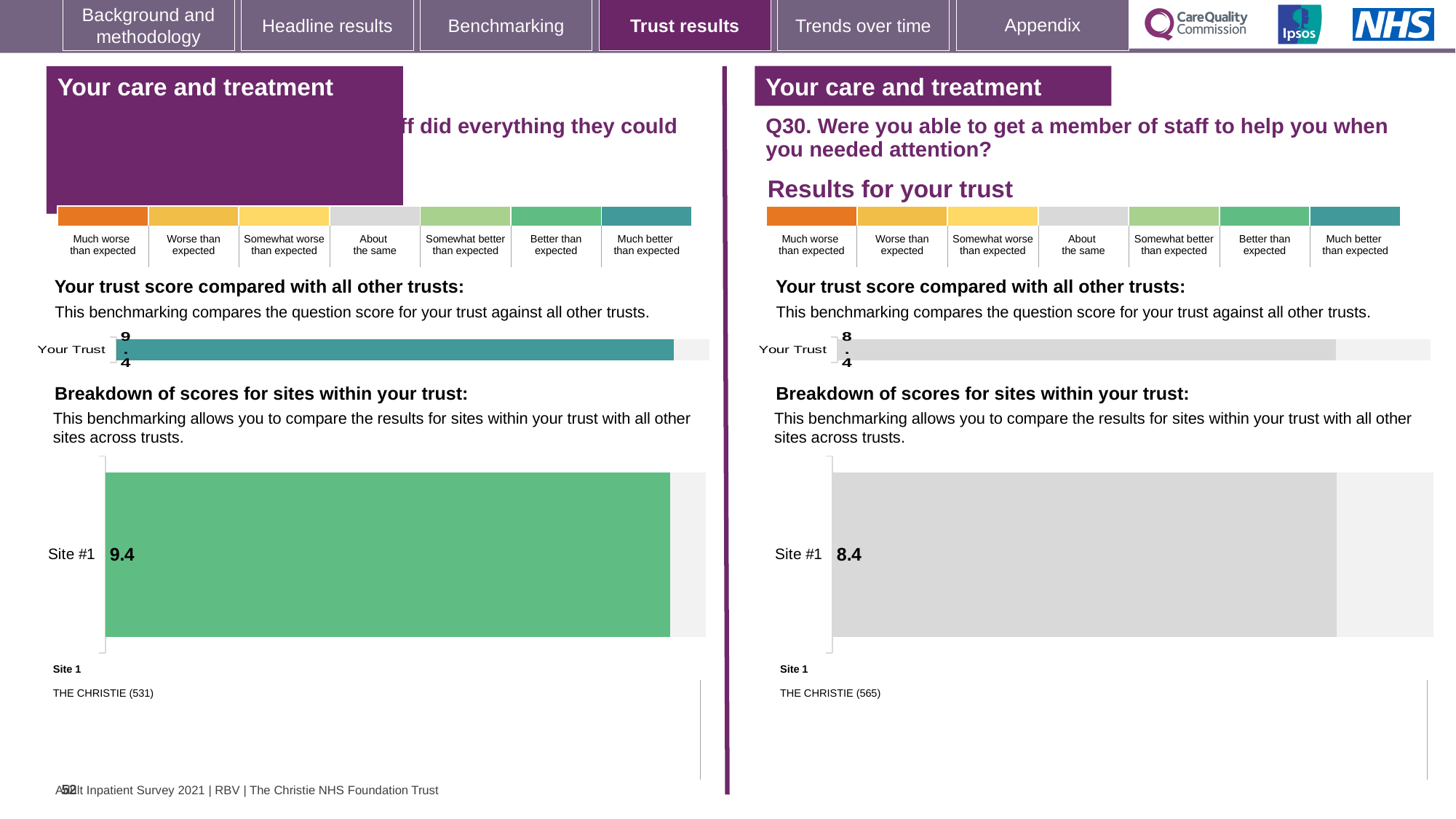
What kind of chart is used to show the Site #1 score on the right-hand Q30 chart? Bar chart On the right-hand Q30 'Breakdown of scores for sites within your trust' chart, what is the score for Site #1? 8.4 What colour is the Site #1 bar on the right-hand Q30 breakdown chart? Grey Which Your Trust score is higher: the left-hand chart or the right-hand Q30 chart? The left-hand chart What colour is the Site #1 bar on the left-hand breakdown chart? Green On the right-hand Q30 chart, what is the score shown for Your Trust? 8.4 How many sites are shown in the left-hand 'Breakdown of scores for sites within your trust' chart? 1 On the left-hand 'Breakdown of scores for sites within your trust' chart, what is the score for Site #1? 9.4 How many bars are plotted in the right-hand Q30 'Your Trust' chart? 1 Which Site #1 score is higher: the one on the left-hand chart or the one on the right-hand Q30 chart? The left-hand chart What is the difference between the Site #1 score on the left-hand chart and the Site #1 score on the right-hand Q30 chart? 1.0 On the left-hand chart, what is the score shown for Your Trust? 9.4